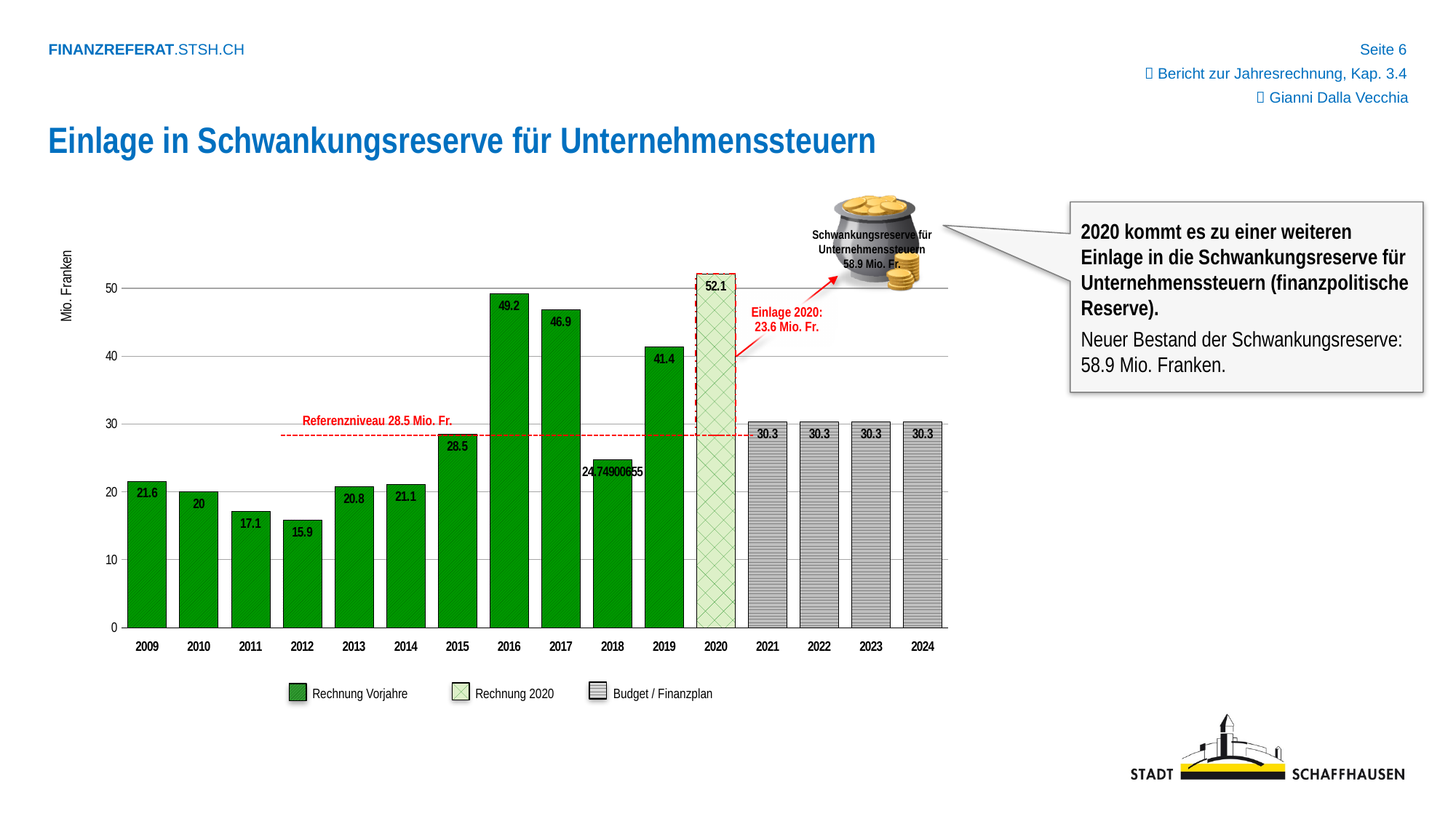
What is the value for 2016? 49.2 Which year has the lowest value? 2012 What is the value for 2020? 52.1 Is the value for 2018 greater or less than 30? less What is the difference between the values for 2016 and 2017? 2.3 How many years are shown on the x axis? 16 What is the label of the y axis? Mio. Franken Which is larger, the value for 2019 or the value for 2015? 2019 Which year has the highest value? 2020 How many series does the legend list? 3 What kind of chart is shown? bar chart What is the value for 2012? 15.9